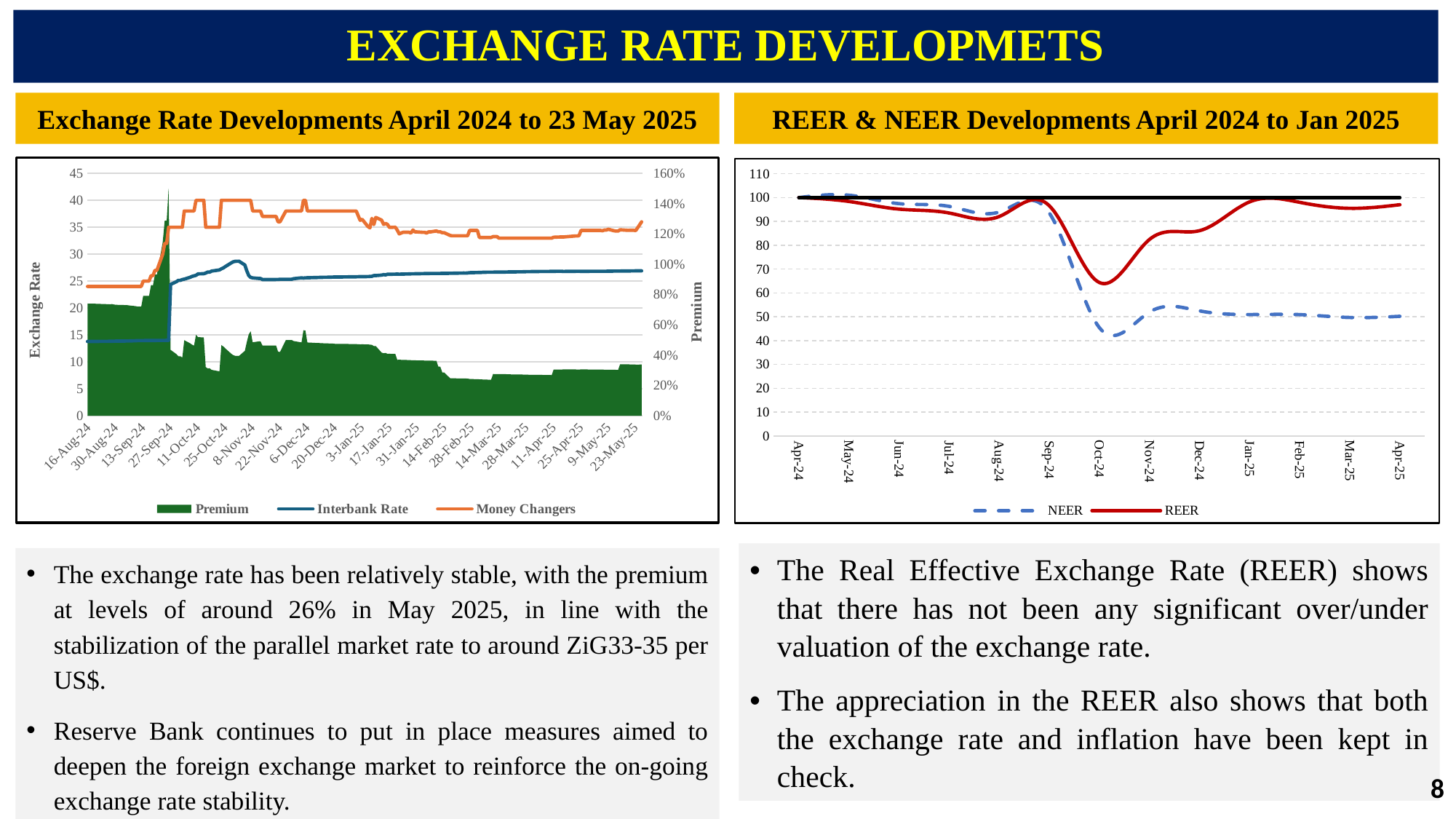
On the Exchange Rate Developments chart, is the Money Changers value at 23-May-25 greater or less than 30 on the Exchange Rate axis? greater What kind of chart is the REER & NEER Developments chart? Line chart On the REER & NEER Developments chart, how many month labels are shown on the x axis? 13 On the REER & NEER Developments chart, is the NEER value at Oct-24 greater or less than 50? less On the REER & NEER Developments chart, does the NEER series rise or fall from Apr-24 to Apr-25? Fall On the Exchange Rate Developments chart, which series is higher at 23-May-25, Interbank Rate or Money Changers? Money Changers On the Exchange Rate Developments chart, how many series does the legend list? 3 On the Exchange Rate Developments chart, which series is shown as a green filled area? Premium On the REER & NEER Developments chart, which series is higher at Apr-25, NEER or REER? REER On the REER & NEER Developments chart, is the REER value at Oct-24 greater or less than 70? less On the REER & NEER Developments chart, how many series does the legend list? 2